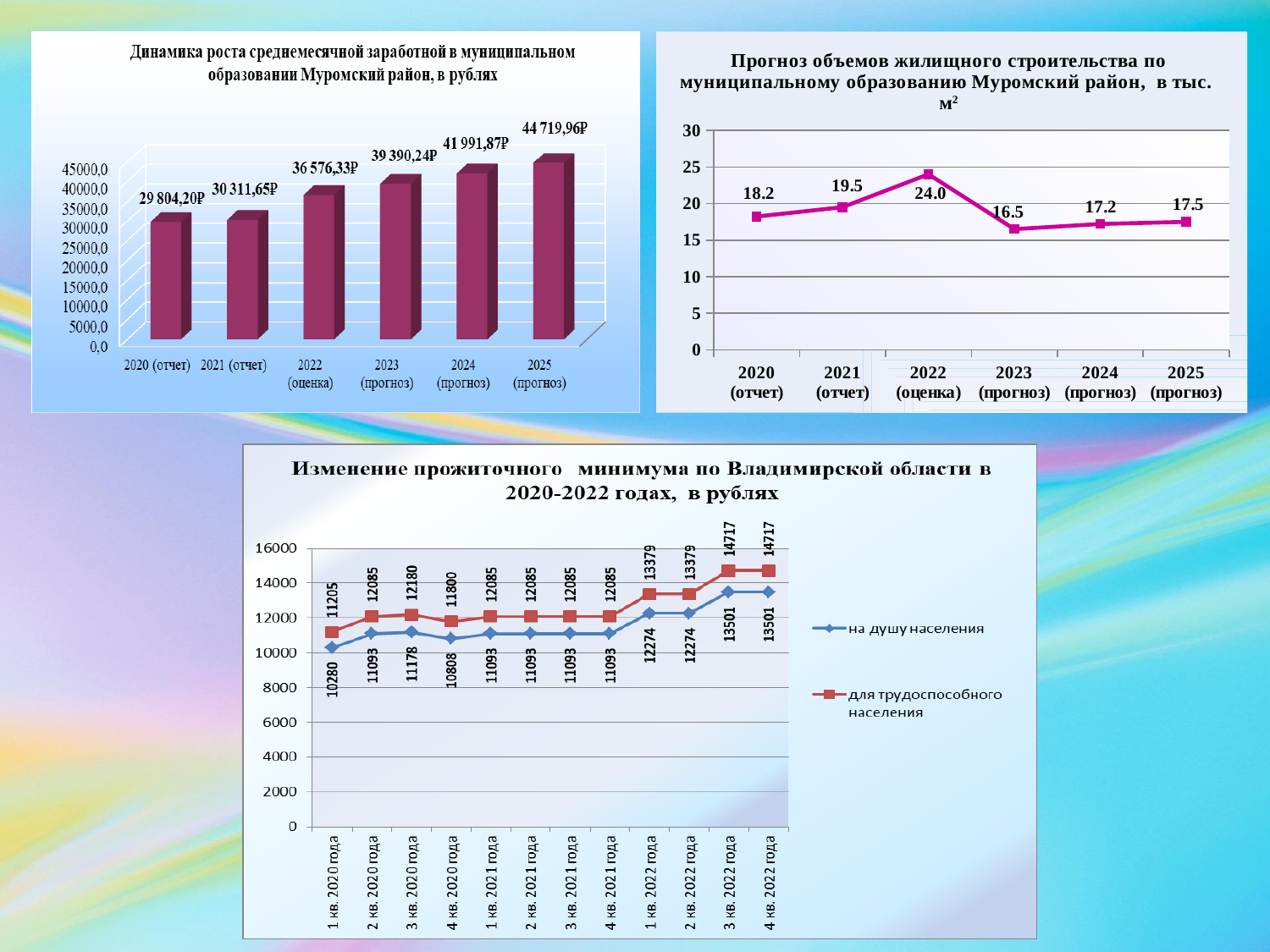
In the bottom chart (Изменение прожиточного минимума), what is the value for 'для трудоспособного населения' in 3 кв. 2022 года? 14717 In the bottom chart (Изменение прожиточного минимума), how many quarters are shown on the x axis? 12 In the top-left chart (Динамика роста среднемесячной заработной платы), what is the value for 2022 (оценка)? 36 576,33₽ In the top-left chart (Динамика роста среднемесячной заработной платы), what kind of chart is it? Bar chart In the top-right chart (Прогноз объемов жилищного строительства), what is the value for 2022 (оценка)? 24.0 In the top-right chart (Прогноз объемов жилищного строительства), how many data points are plotted? 6 In the top-right chart (Прогноз объемов жилищного строительства), is the value for 2021 (отчет) larger or smaller than the value for 2024 (прогноз)? Larger In the top-right chart (Прогноз объемов жилищного строительства), which year has the lowest value? 2023 (прогноз) In the top-left chart (Динамика роста среднемесячной заработной платы), which year has the highest value? 2025 (прогноз) In the bottom chart (Изменение прожиточного минимума), how many series does the legend list? 2 In the bottom chart (Изменение прожиточного минимума), what is the difference between 'для трудоспособного населения' and 'на душу населения' in 1 кв. 2020 года? 925 In the top-left chart (Динамика роста среднемесячной заработной платы), what is the difference between the 2021 (отчет) and 2020 (отчет) values? 507,45₽